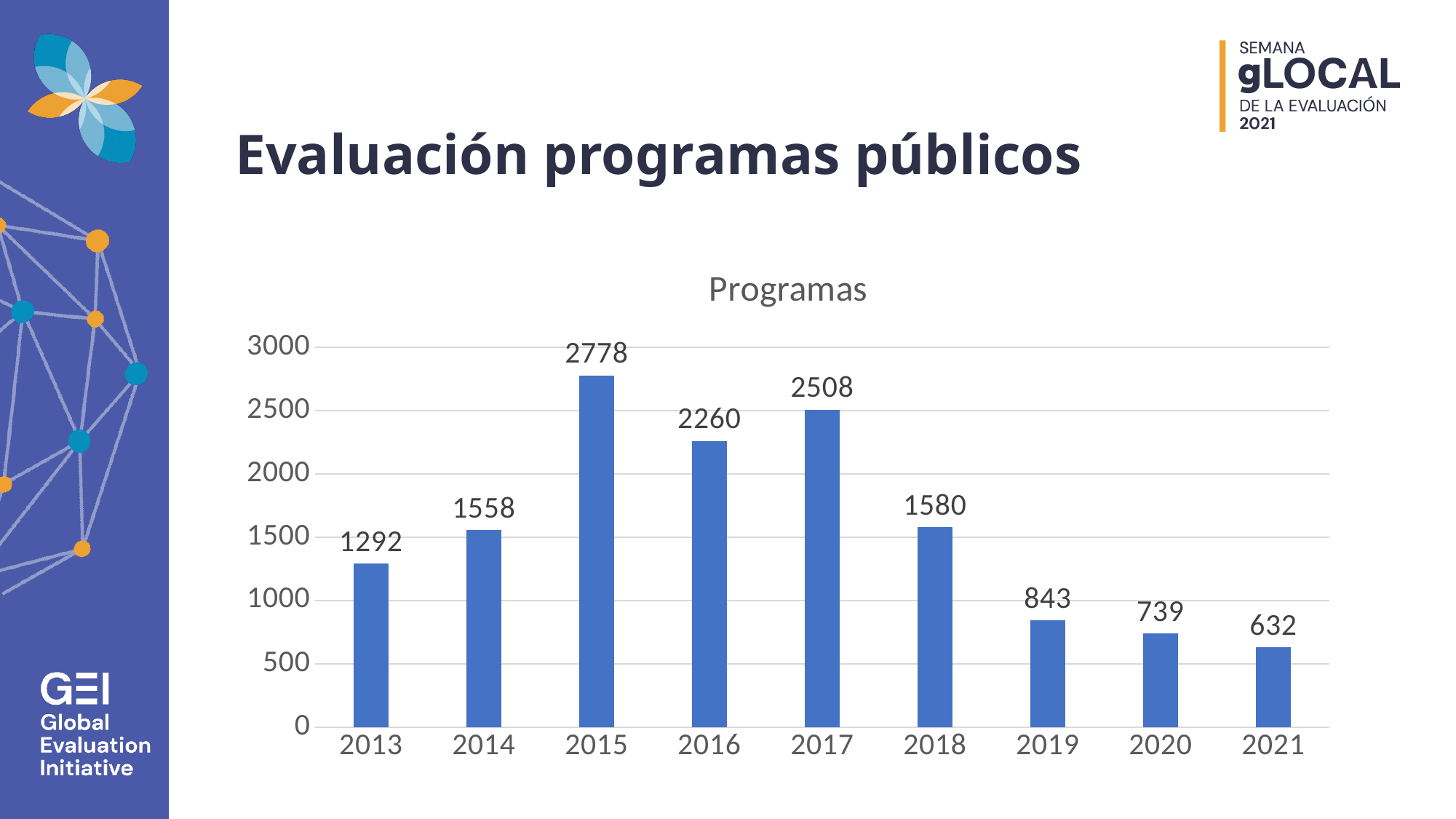
What is the title of the chart? Programas How many years are shown on the x axis? 9 What kind of chart is shown on the slide? bar chart What is the difference between the values for 2015 and 2016? 518 What is the value for 2021? 632 What is the value for 2018? 1580 What is the value for 2015? 2778 What is the difference between the values for 2019 and 2020? 104 Which year has the highest value? 2015 Is the value for 2017 greater or less than 2000? greater Which year has the lowest value? 2021 Which is larger, the value for 2014 or the value for 2018? 2018